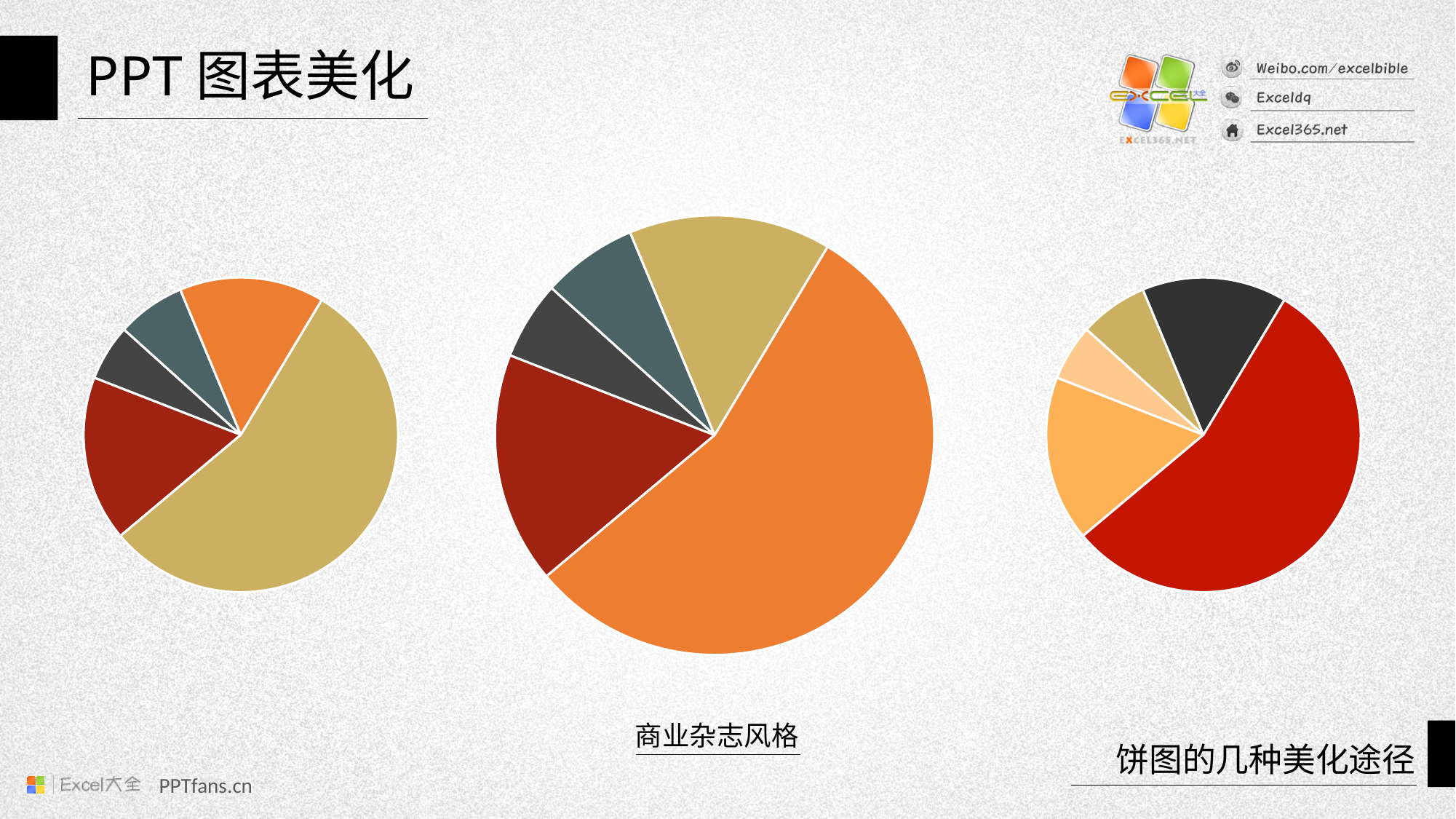
What kind of chart is the middle chart on the slide? pie chart In the left pie chart, which colour slice is the largest? tan (gold) How many slices does the right pie chart have? 5 In the right pie chart, which colour slice is the largest? red What kind of chart is the left chart on the slide? pie chart In the middle pie chart, which colour slice is the largest? orange How many pie charts are shown on the slide? 3 How many slices does the left pie chart have? 5 In the middle pie chart, which is larger: the orange slice or the dark red slice? orange What caption is written below the middle pie chart? 商业杂志风格 In the left pie chart, which is larger: the dark red slice or the dark grey slice? dark red How many slices does the middle pie chart have? 5